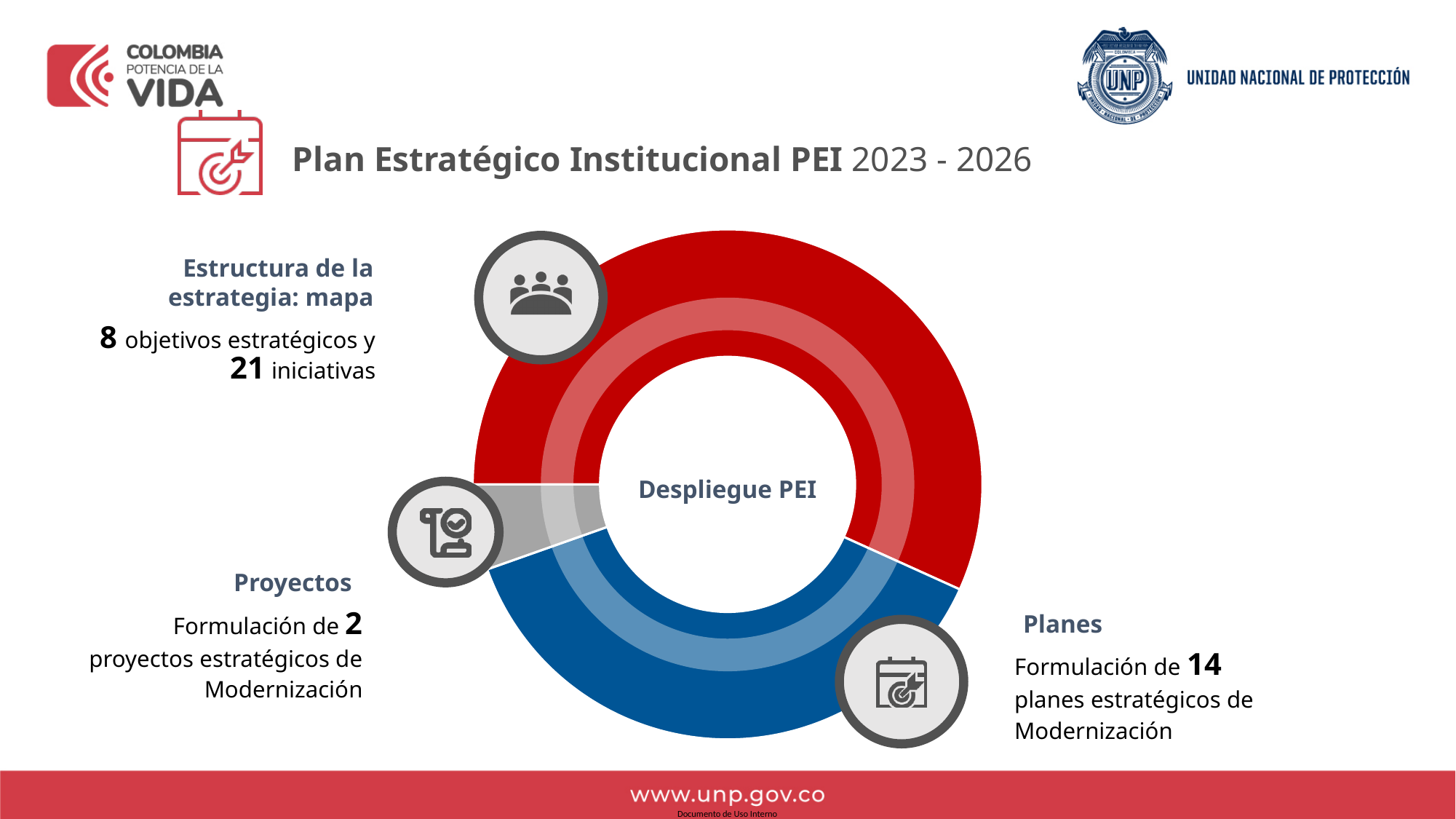
How many segments does the doughnut chart have? 3 What kind of chart is shown in the centre of the slide? Doughnut (pie) chart What three colours are used for the segments of the doughnut chart? Red, blue and gray What text is written in the centre of the doughnut chart? Despliegue PEI Which segment of the doughnut chart is larger, the blue one or the gray one? Blue Which colour segment of the doughnut chart is the largest? Red Which colour segment of the doughnut chart is the smallest? Gray Which segment of the doughnut chart is larger, the red one or the blue one? Red